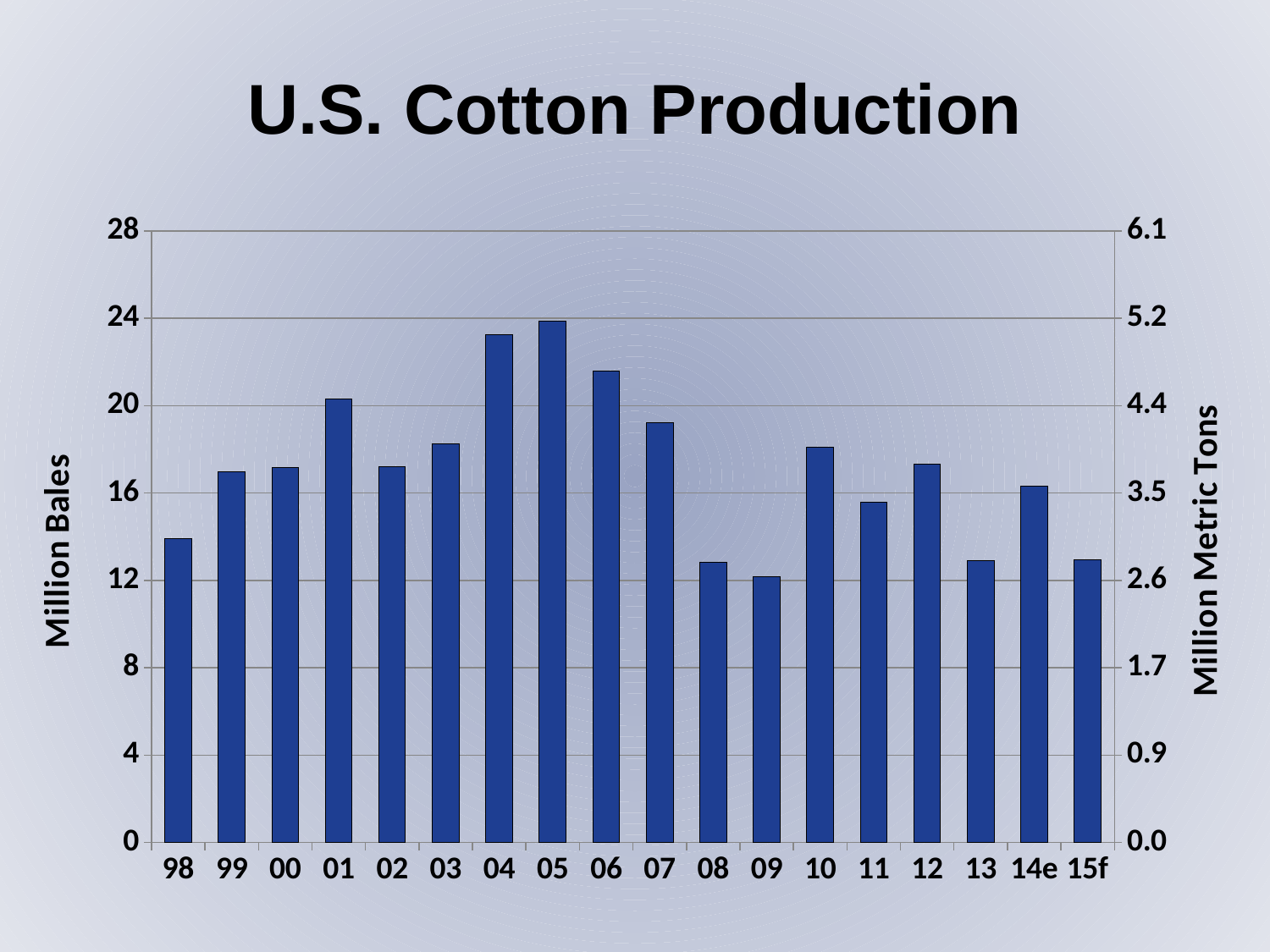
Which year has the larger production, 04 or 07? 04 Which year has the lowest cotton production? 09 Do the values rise or fall from 05 to 09? fall What is the title of the chart? U.S. Cotton Production Which year has the larger production, 10 or 11? 10 Which year has the highest cotton production? 05 Is the value for 98 greater or less than 16 million bales? less What kind of chart is shown on the slide? Bar chart How many years (bars) are shown on the x axis? 18 Is the value for 09 greater or less than 16 million bales? less Is the value for 08 greater or less than 12 million bales? greater